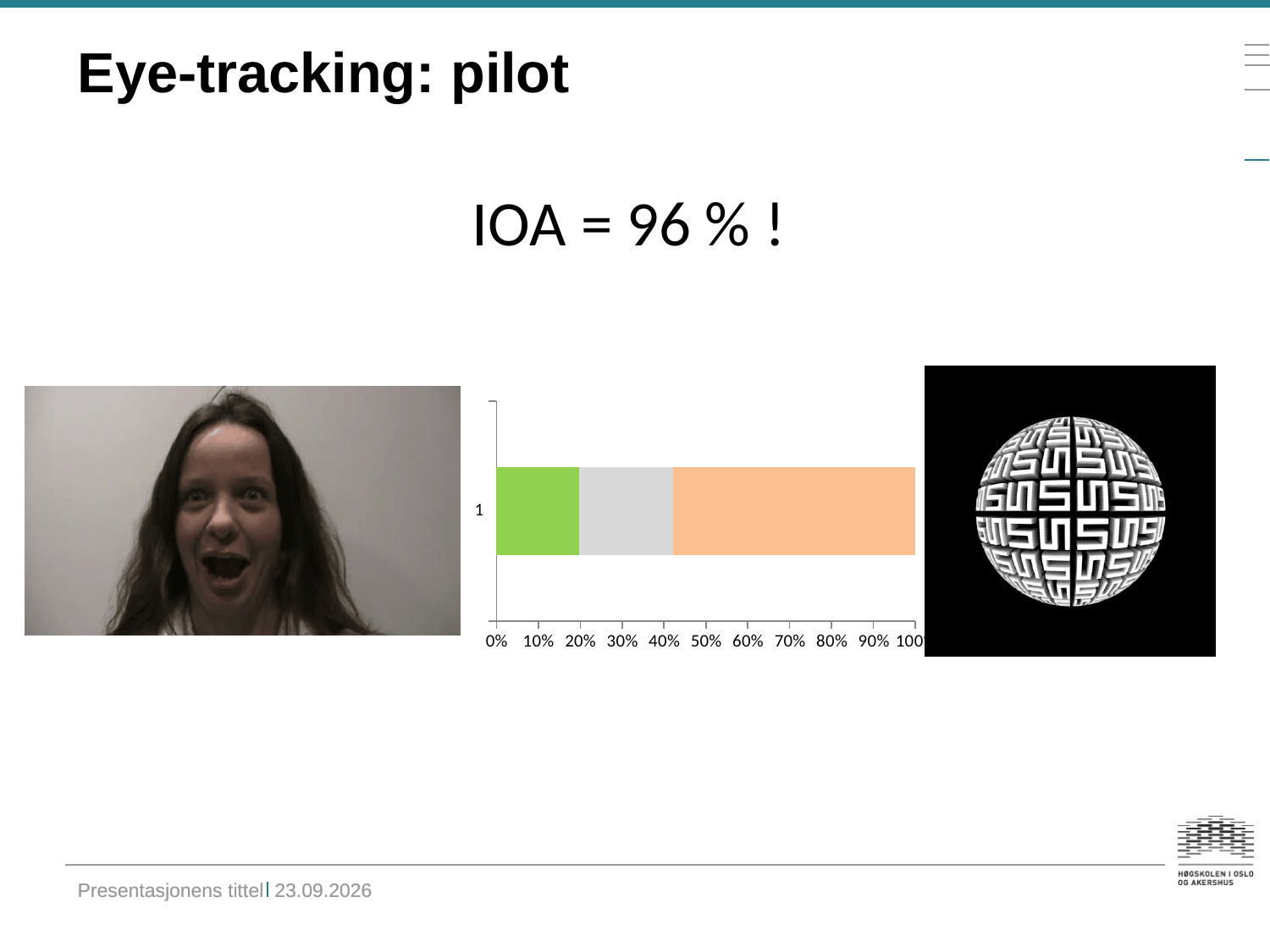
How many coloured segments make up the stacked bar? 3 Is the width of the orange segment greater or less than 50%? greater What value does the stacked bar reach in total on the horizontal axis? 100% What is the highest tick value shown on the horizontal axis? 100% Are the bars in the chart drawn horizontally or vertically? horizontally How many categories are plotted on the chart's vertical axis? 1 What kind of chart is shown on the slide? bar chart Is the width of the green segment greater or less than 30%? less Is the width of the grey segment greater or less than 40%? less What is the label of the single category on the chart? 1 Is the orange segment of the bar larger or smaller than the green segment? larger Which coloured segment of the stacked bar is the largest? orange